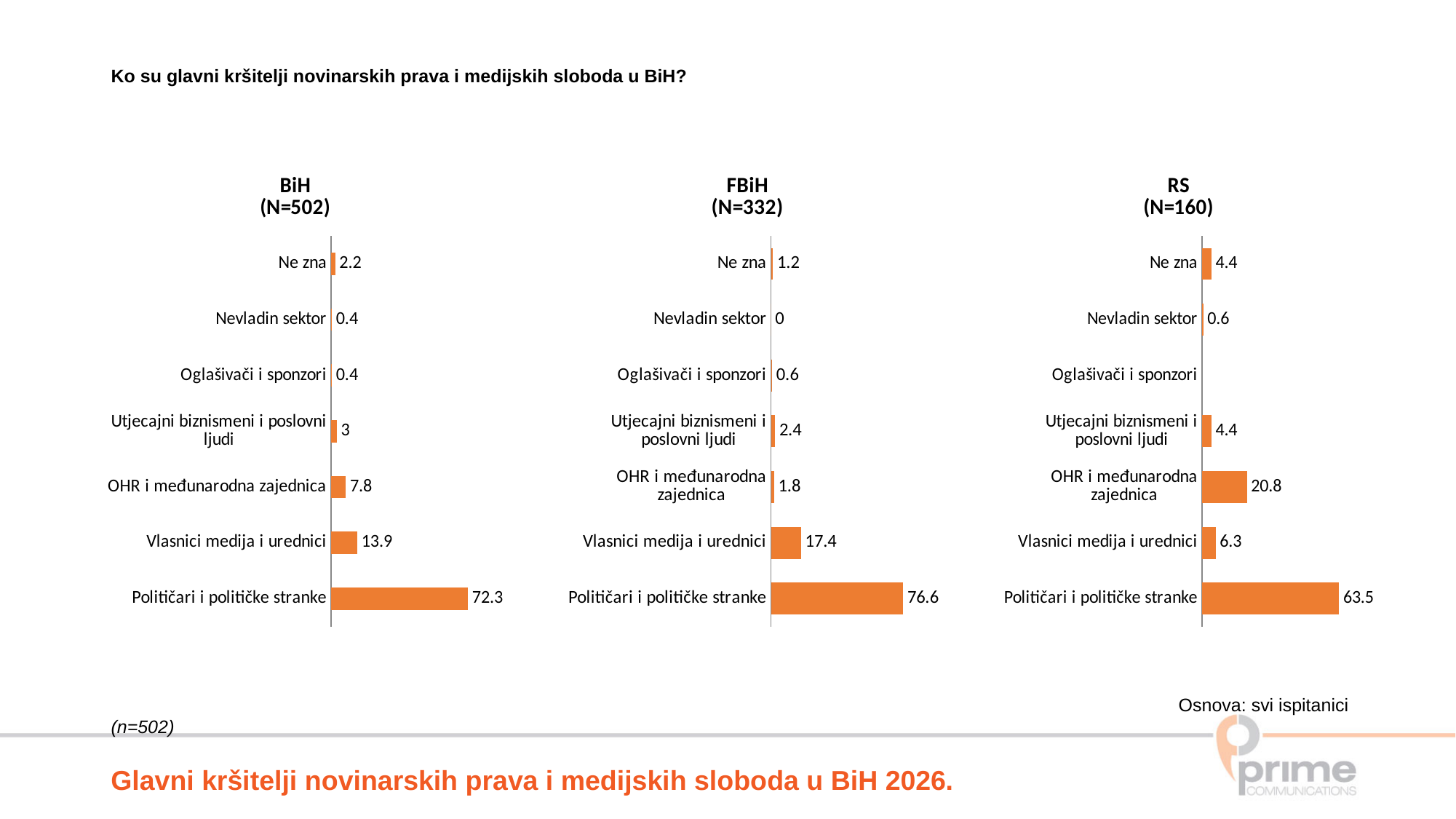
What type of chart is used for the FBiH (N=332) data? Bar chart In the RS (N=160) chart, which is larger: OHR i međunarodna zajednica or Vlasnici medija i urednici? OHR i međunarodna zajednica In the FBiH (N=332) chart, what is the value for Nevladin sektor? 0 How many charts are shown on the slide? 3 In the BiH (N=502) chart, what is the difference between Vlasnici medija i urednici and OHR i međunarodna zajednica? 6.1 In the RS (N=160) chart, what is the value for OHR i međunarodna zajednica? 20.8 In the BiH (N=502) chart, what is the value for Političari i političke stranke? 72.3 In the FBiH (N=332) chart, what is the value for Vlasnici medija i urednici? 17.4 How many categories are listed in the BiH (N=502) chart? 7 In the BiH (N=502) chart, which category has the highest value? Političari i političke stranke In the RS (N=160) chart, which category has the lowest labelled value? Nevladin sektor Which chart shows the highest value for Političari i političke stranke: BiH, FBiH or RS? FBiH